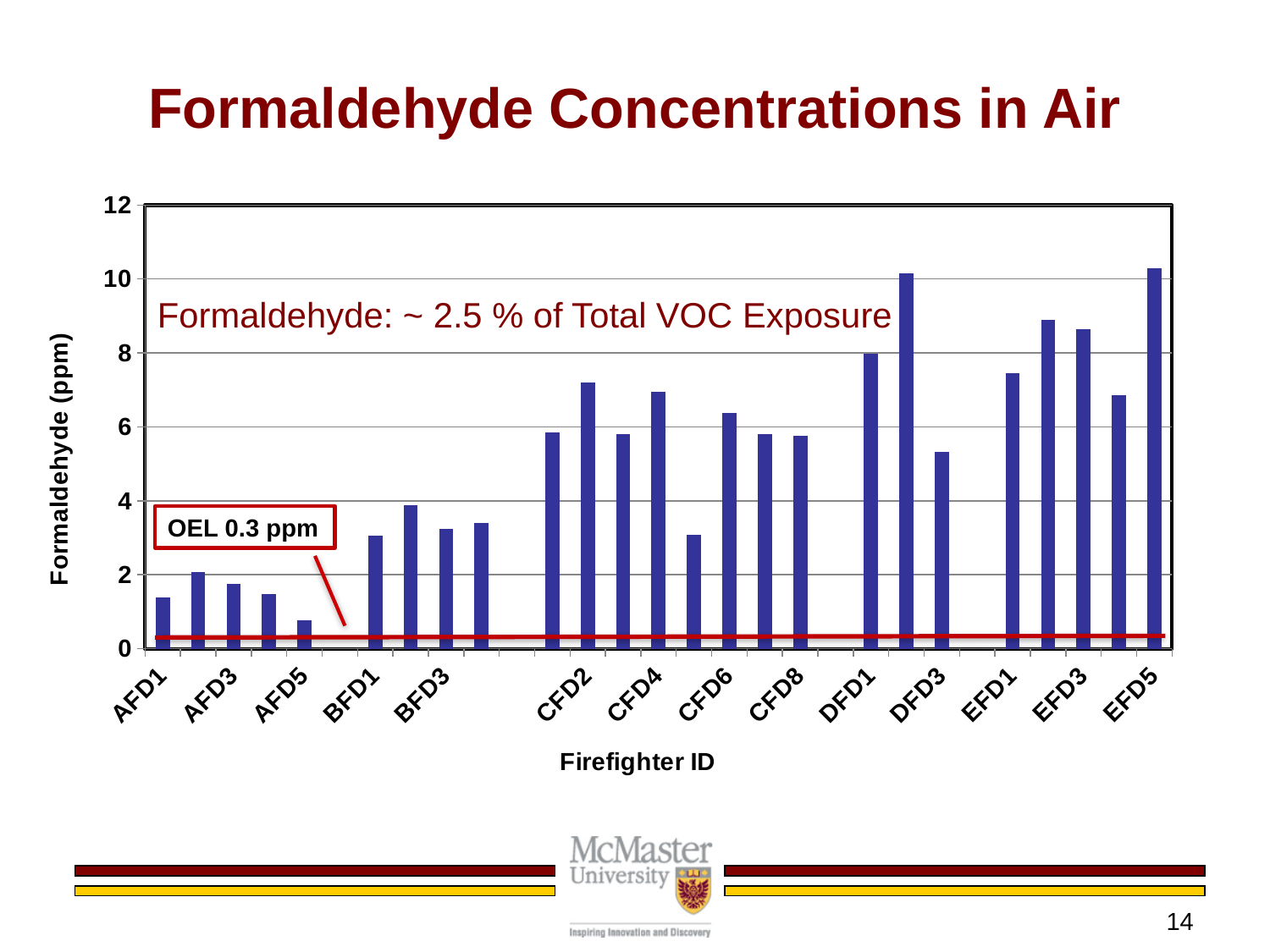
What kind of chart is shown on the slide? bar chart Is the value for AFD1 greater or less than 2? less Is the value for BFD1 greater or less than 2? greater Is the value for CFD2 greater or less than 4? greater What is the label of the y axis? Formaldehyde (ppm) Which has a higher formaldehyde concentration, AFD1 or CFD2? CFD2 Which firefighter ID has the lowest formaldehyde concentration? AFD5 What is the OEL value marked on the chart? 0.3 ppm Which has a higher formaldehyde concentration, EFD3 or DFD3? EFD3